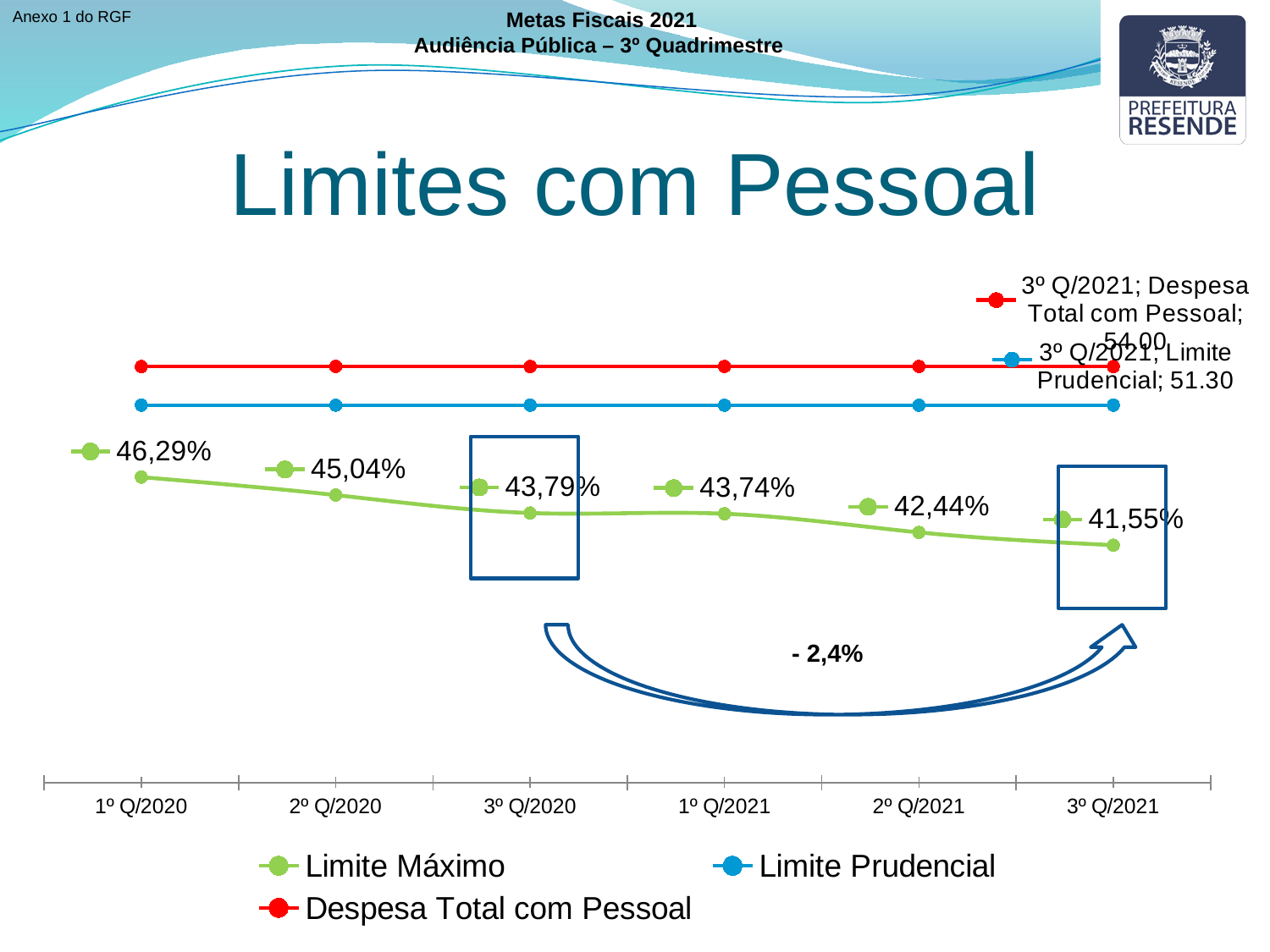
How many series does the legend list? 3 What is the value of the Limite Máximo series for 3º Q/2021? 41,55% What type of chart is shown on the slide? Line chart How many periods are shown on the x axis? 6 What value is labelled for Limite Prudencial at 3º Q/2021? 51.30 What value is labelled for Despesa Total com Pessoal at 3º Q/2021? 54.00 What is the difference between the Limite Máximo values for 1º Q/2020 and 3º Q/2021? 4,74% In which period is the Limite Máximo series at its lowest? 3º Q/2021 What is the title of the chart? Limites com Pessoal What is the value of the Limite Máximo series for 1º Q/2020? 46,29% In which period is the Limite Máximo series at its highest? 1º Q/2020 What is the value of the Limite Máximo series for 2º Q/2021? 42,44%